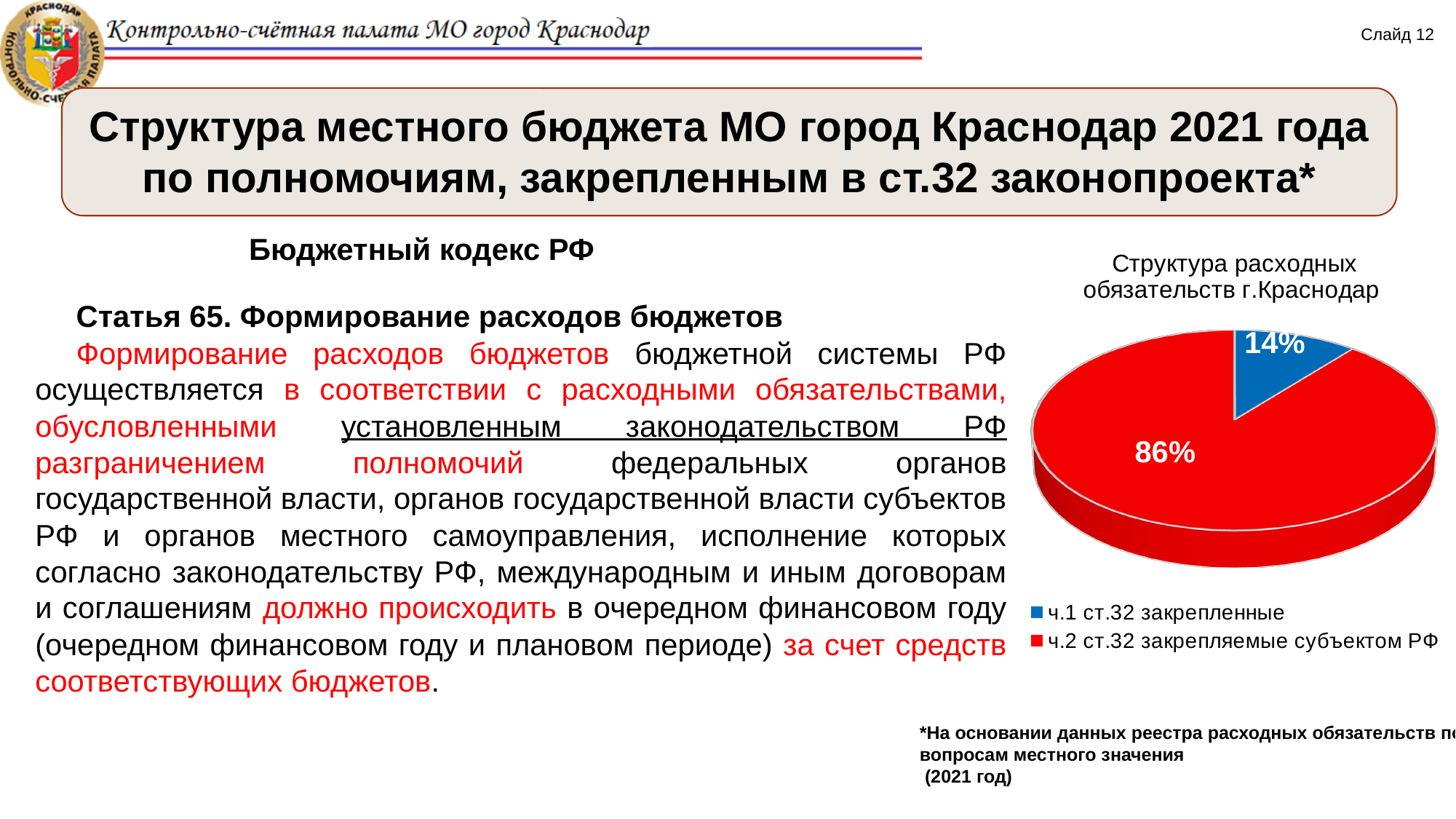
How many slices does the pie chart have? 2 What is the difference in percentage points between the "ч.2 ст.32 закрепляемые субъектом РФ" slice and the "ч.1 ст.32 закрепленные" slice? 72 What share of the pie does "ч.1 ст.32 закрепленные" take? 14% Which slice of the pie is the smallest? ч.1 ст.32 закрепленные How many entries does the chart legend list? 2 Which is larger: the share for "ч.1 ст.32 закрепленные" or the share for "ч.2 ст.32 закрепляемые субъектом РФ"? ч.2 ст.32 закрепляемые субъектом РФ What kind of chart is shown on the slide? pie chart What is the title of the chart? Структура расходных обязательств г.Краснодар What share of the pie does "ч.2 ст.32 закрепляемые субъектом РФ" take? 86% What colour is the slice for "ч.1 ст.32 закрепленные"? blue Which slice of the pie is the largest? ч.2 ст.32 закрепляемые субъектом РФ